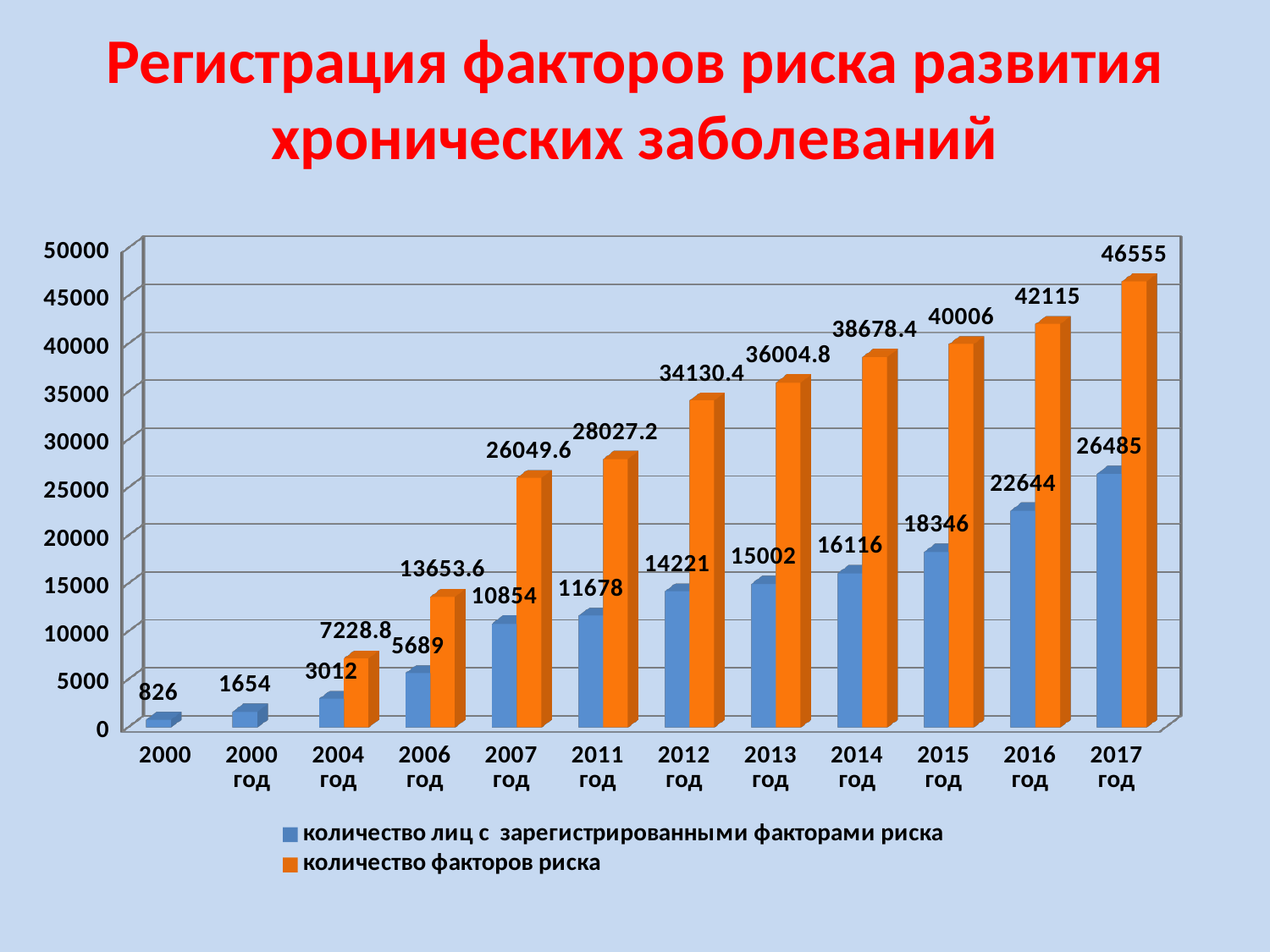
Is the value of "количество факторов риска" for 2014 год greater or less than 35000? greater What is the value of "количество лиц с зарегистрированными факторами риска" for 2015 год? 18346 Which year has the lowest value of "количество факторов риска"? 2004 год Which year has the highest value of "количество факторов риска"? 2017 год How many series does the legend list? 2 What is the value of "количество лиц с зарегистрированными факторами риска" for 2012 год? 14221 How many categories are shown on the x axis? 12 What is the value of "количество факторов риска" for 2007 год? 26049.6 Which is larger for 2013 год: "количество факторов риска" or "количество лиц с зарегистрированными факторами риска"? количество факторов риска What is the value of "количество факторов риска" for 2017 год? 46555 What is the difference between "количество факторов риска" and "количество лиц с зарегистрированными факторами риска" for 2016 год? 19471 Does "количество лиц с зарегистрированными факторами риска" rise or fall from 2004 год to 2017 год? rise